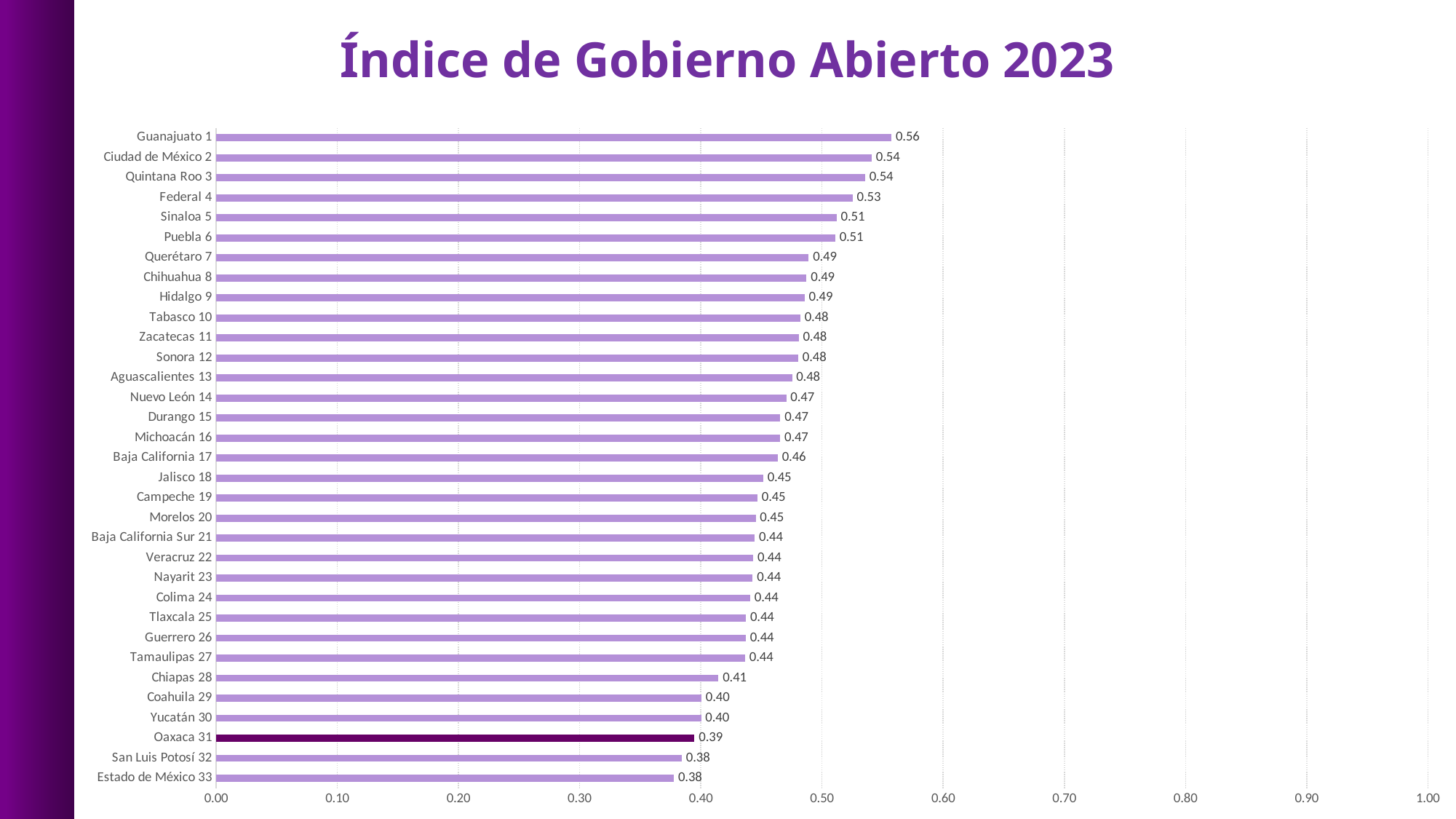
What is the difference between the values for Guanajuato 1 and Oaxaca 31? 0.17 Which category has the highest value? Guanajuato 1 What is the value for Chiapas 28? 0.41 Is the value for Guanajuato 1 greater or less than 0.50? greater Which has a larger value, Sinaloa 5 or Chiapas 28? Sinaloa 5 Which category's bar is drawn in a darker colour than the others? Oaxaca 31 What is the value for Nuevo León 14? 0.47 What is the title of the chart? Índice de Gobierno Abierto 2023 How many categories are shown in the chart? 33 What is the value for Guanajuato 1? 0.56 What kind of chart is shown on the slide? bar chart What is the value for Oaxaca 31? 0.39